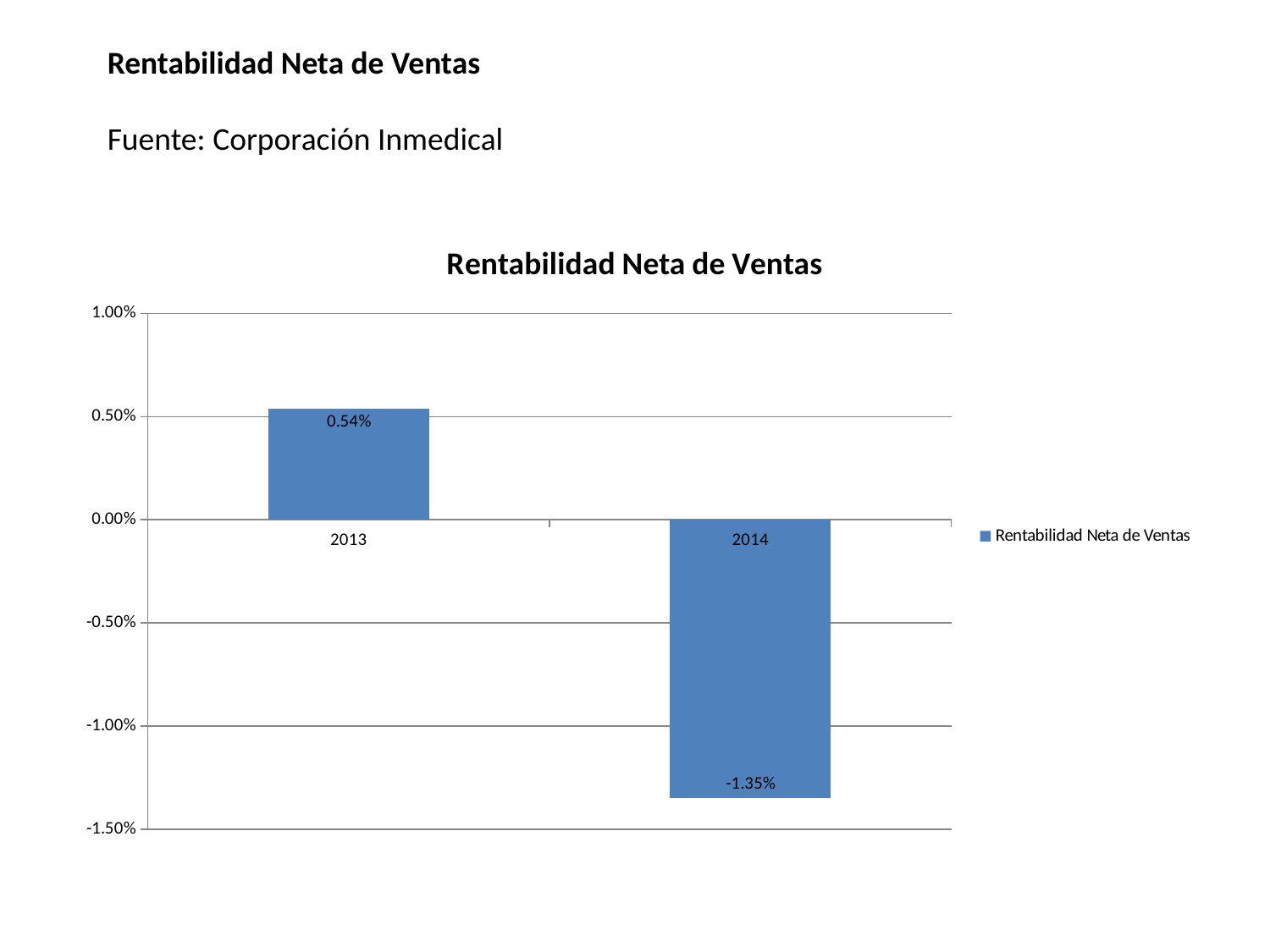
Which is larger, the value for 2013 or the value for 2014? 2013 What is the difference between the values for 2013 and 2014? 1.89% Which year has the lowest value? 2014 Is the value for 2014 greater or less than -1.00%? less Which year has the highest value? 2013 What is the value for 2014? -1.35% Is the value for 2013 greater or less than 0.50%? greater What is the value for 2013? 0.54% What kind of chart is shown? bar chart How many years are shown on the x axis? 2 How many series does the legend list? 1 Do the values rise or fall from 2013 to 2014? fall